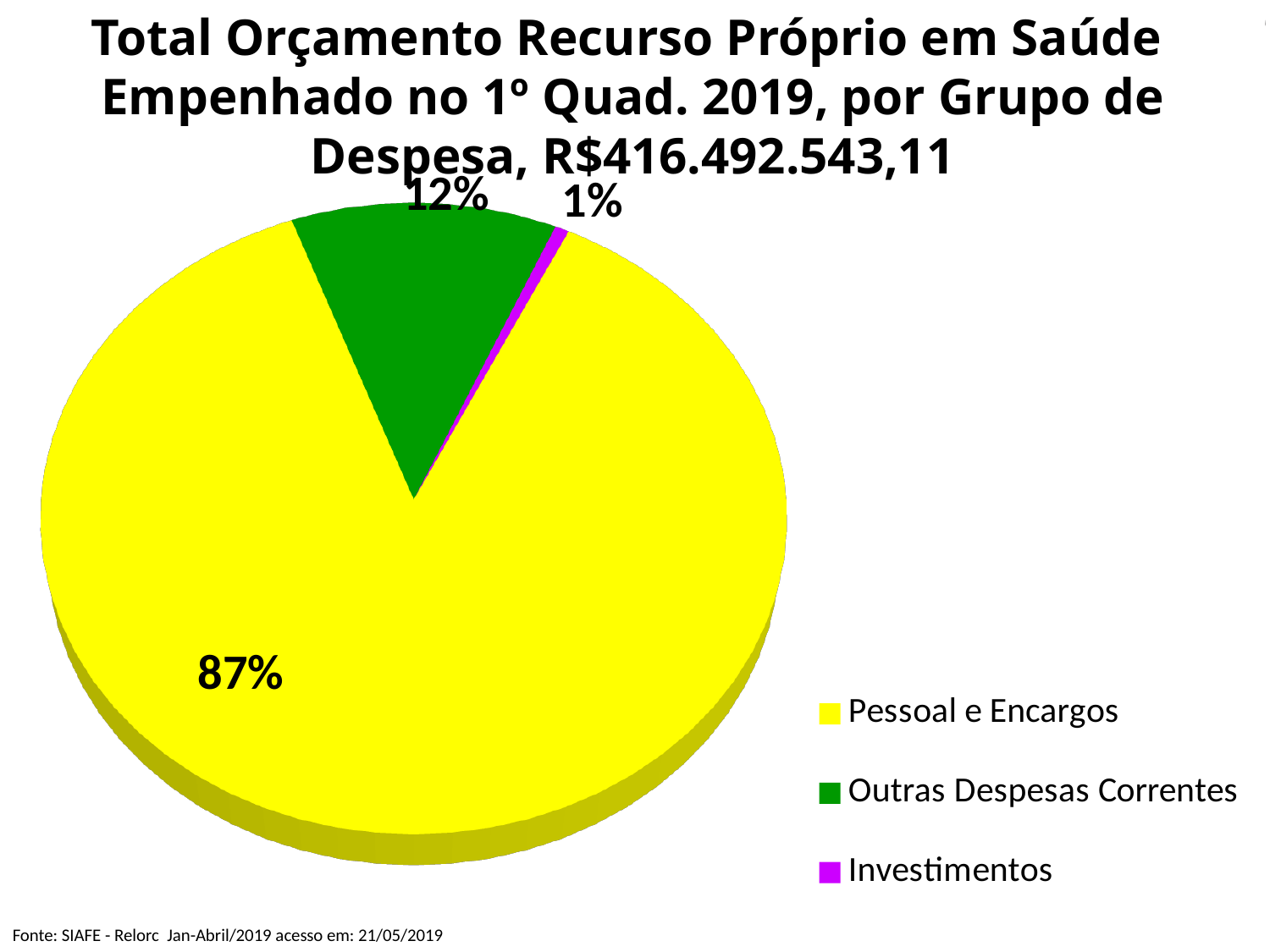
What colour is the Investimentos slice in the pie chart? Magenta (purple) Which expense group has the largest slice of the pie? Pessoal e Encargos What is the difference in percentage points between the Pessoal e Encargos slice and the Outras Despesas Correntes slice? 75 percentage points What share of the pie does Investimentos represent? 1% What share of the pie does Pessoal e Encargos represent? 87% Which expense group has the smallest slice of the pie? Investimentos Which is larger, the Outras Despesas Correntes slice or the Investimentos slice? Outras Despesas Correntes What kind of chart is shown on the slide? Pie chart What share of the pie does Outras Despesas Correntes represent? 12% How many expense groups are shown in the pie chart? 3 What total amount in R$ is stated in the chart title? R$416.492.543,11 What is the difference in percentage points between the Outras Despesas Correntes slice and the Investimentos slice? 11 percentage points